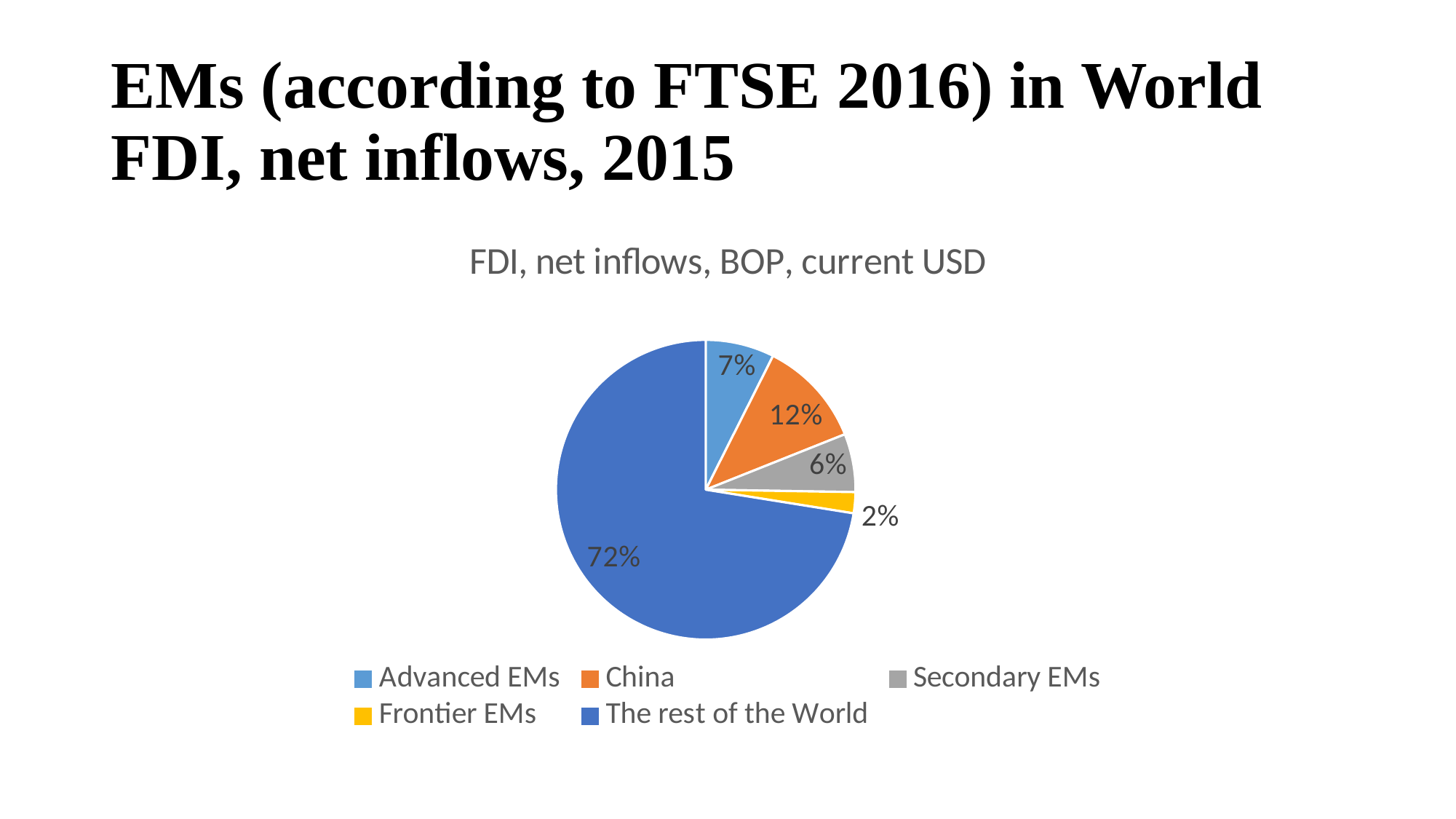
Which category has the largest slice of the pie? The rest of the World What kind of chart is shown on the slide? Pie chart What is the value shown for Secondary EMs? 6% What is the difference in percentage points between China and Advanced EMs? 5 What share of the pie does China account for? 12% How many categories does the pie chart show? 5 Which is larger, the share for China or the share for Secondary EMs? China What share of the pie does The rest of the World account for? 72% Which category has the smallest slice of the pie? Frontier EMs What is the title of the chart? FDI, net inflows, BOP, current USD What is the value shown for Advanced EMs? 7% What is the value shown for Frontier EMs? 2%